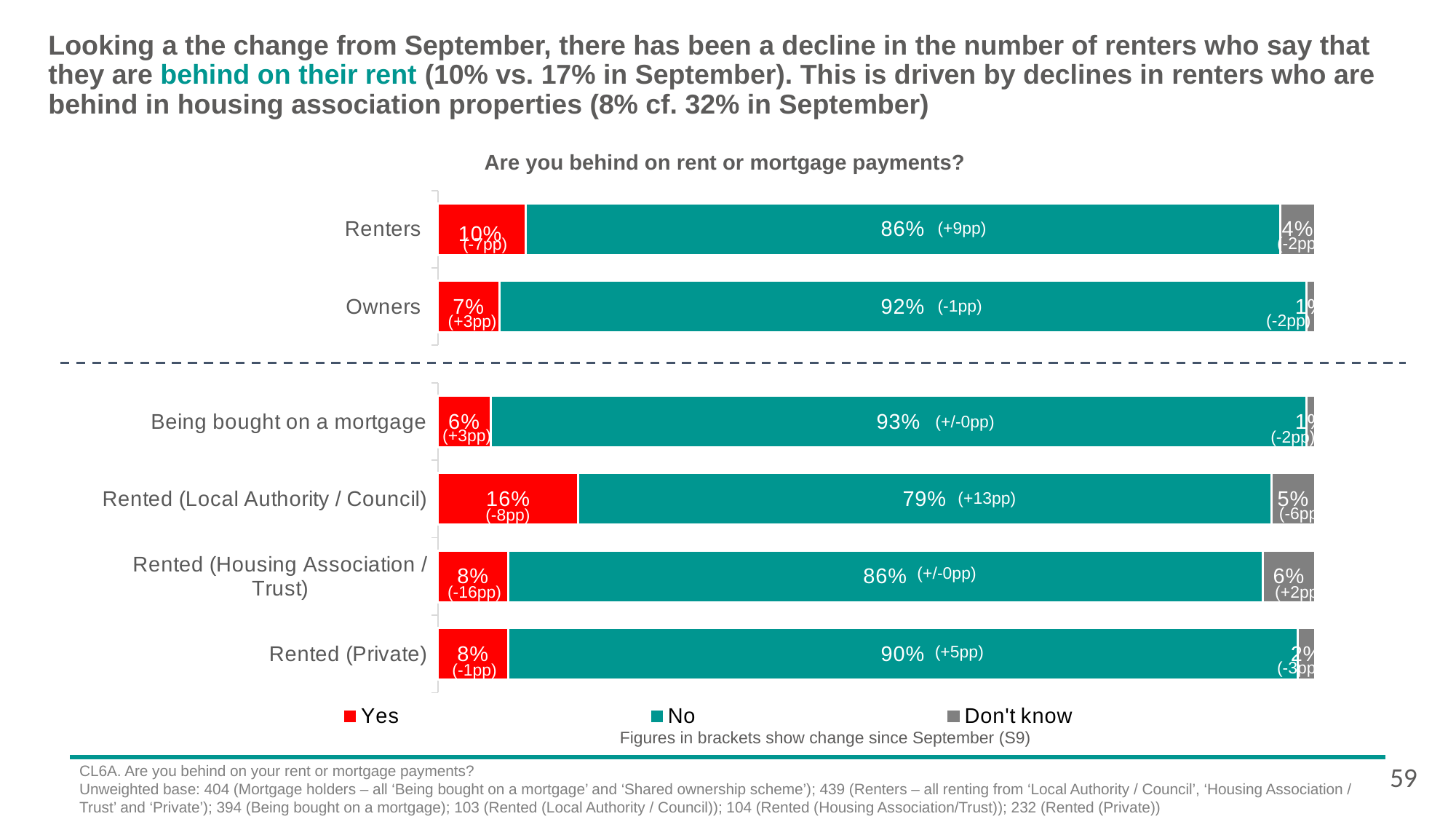
What change since September is shown in brackets for the 'Yes' value of Rented (Housing Association / Trust)? -16pp What is the 'No' value for Rented (Local Authority / Council)? 79% Which category has the highest 'Yes' value? Rented (Local Authority / Council) Which category has the highest 'No' value? Being bought on a mortgage How many categories are shown on the chart? 6 What percentage of Renters answered 'Yes' to being behind on rent or mortgage payments? 10% What is the 'Don't know' value for Rented (Housing Association / Trust)? 6% How many series does the legend list? 3 What is the difference between the 'Yes' values for Renters and Owners? 3 percentage points What is the title of the chart? Are you behind on rent or mortgage payments? What kind of chart is shown on the slide? Stacked bar chart Which is larger, the 'No' value for Owners or the 'No' value for Rented (Private)? Owners